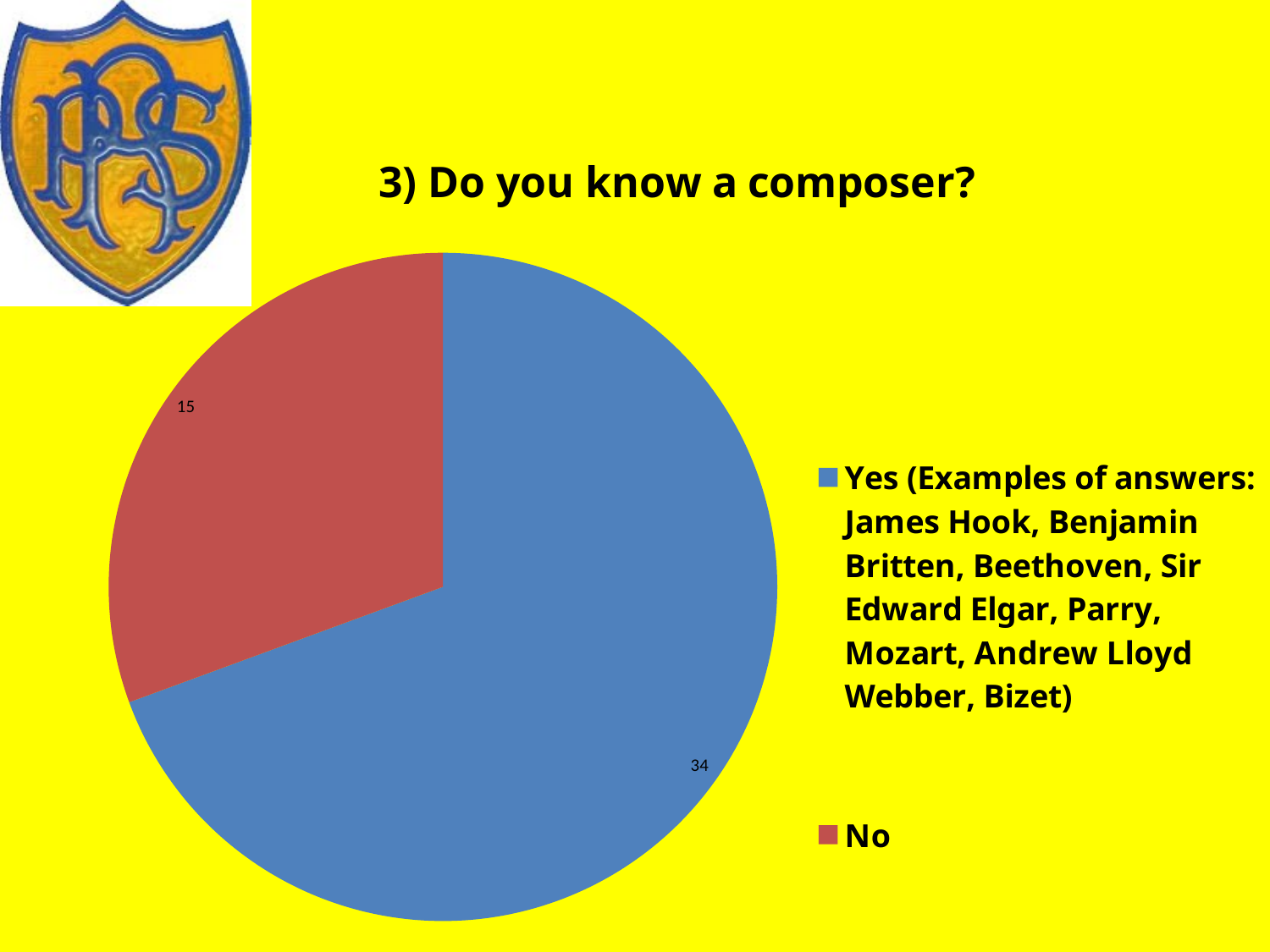
Is the value for "Yes" larger or smaller than the value for "No"? larger Which response has the larger slice of the pie? Yes What is the title of the chart? 3) Do you know a composer? What colour is the "No" slice of the pie? red What type of chart is shown on the slide? pie chart How many more people answered "Yes" than "No"? 19 How many people answered "Yes" to knowing a composer? 34 What is the total number of responses shown in the pie chart? 49 Which response has the smaller slice of the pie? No How many entries does the legend list? 2 How many people answered "No"? 15 How many slices does the pie chart have? 2